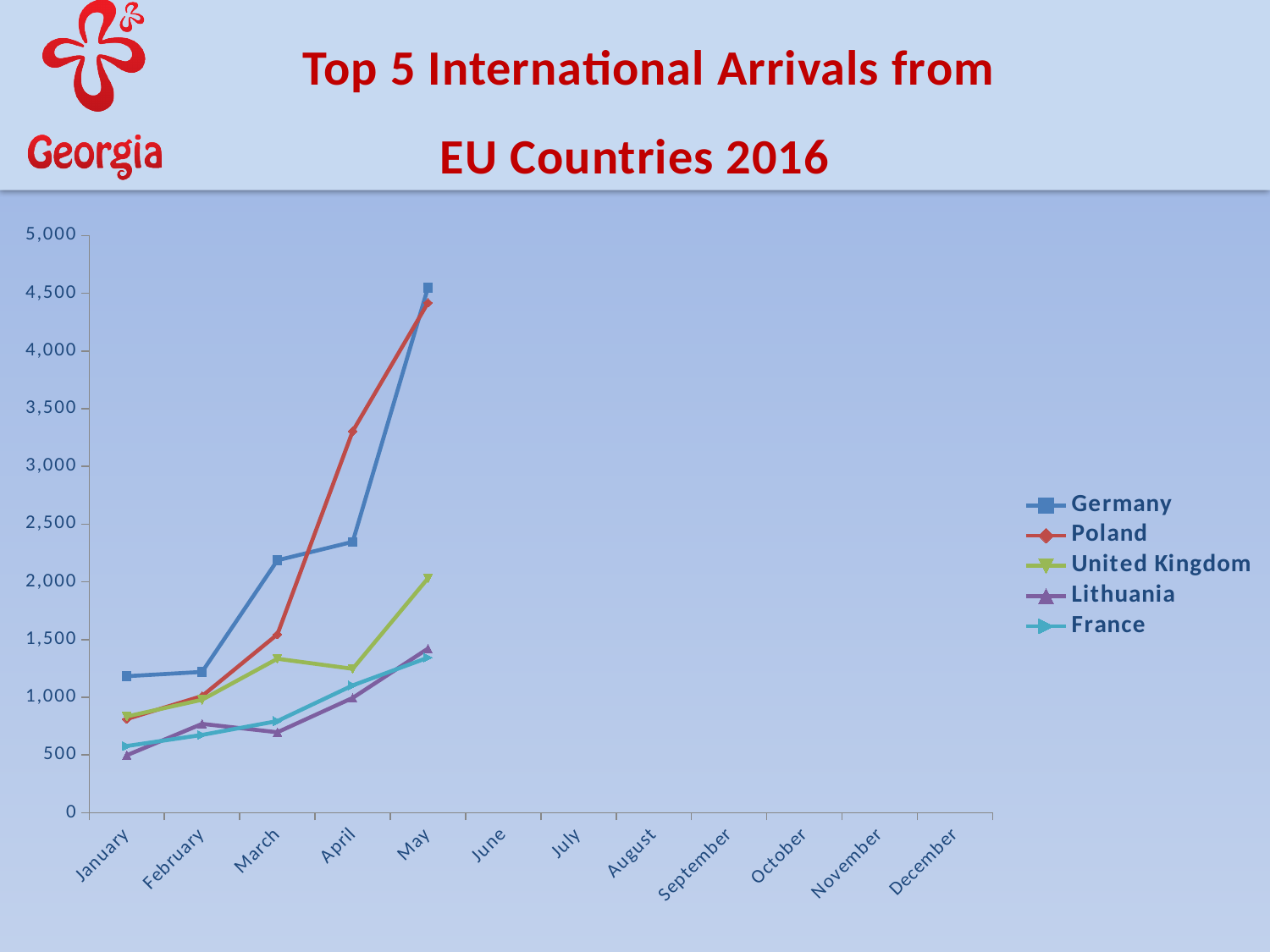
Which country has the highest value in April? Poland Which is larger in March, the value for Germany or the value for United Kingdom? Germany Is the value for France in February greater or less than 1,000? less Is the value for Poland in April greater or less than 3,000? greater Which country has the lowest value in May? France Do the values for Germany rise or fall from January to May? rise What is the title of the chart? Top 5 International Arrivals from EU Countries 2016 What kind of chart is shown on the slide? line chart Is the value for Germany in May greater or less than 4,000? greater How many series does the legend list? 5 How many months on the x axis have plotted data? 5